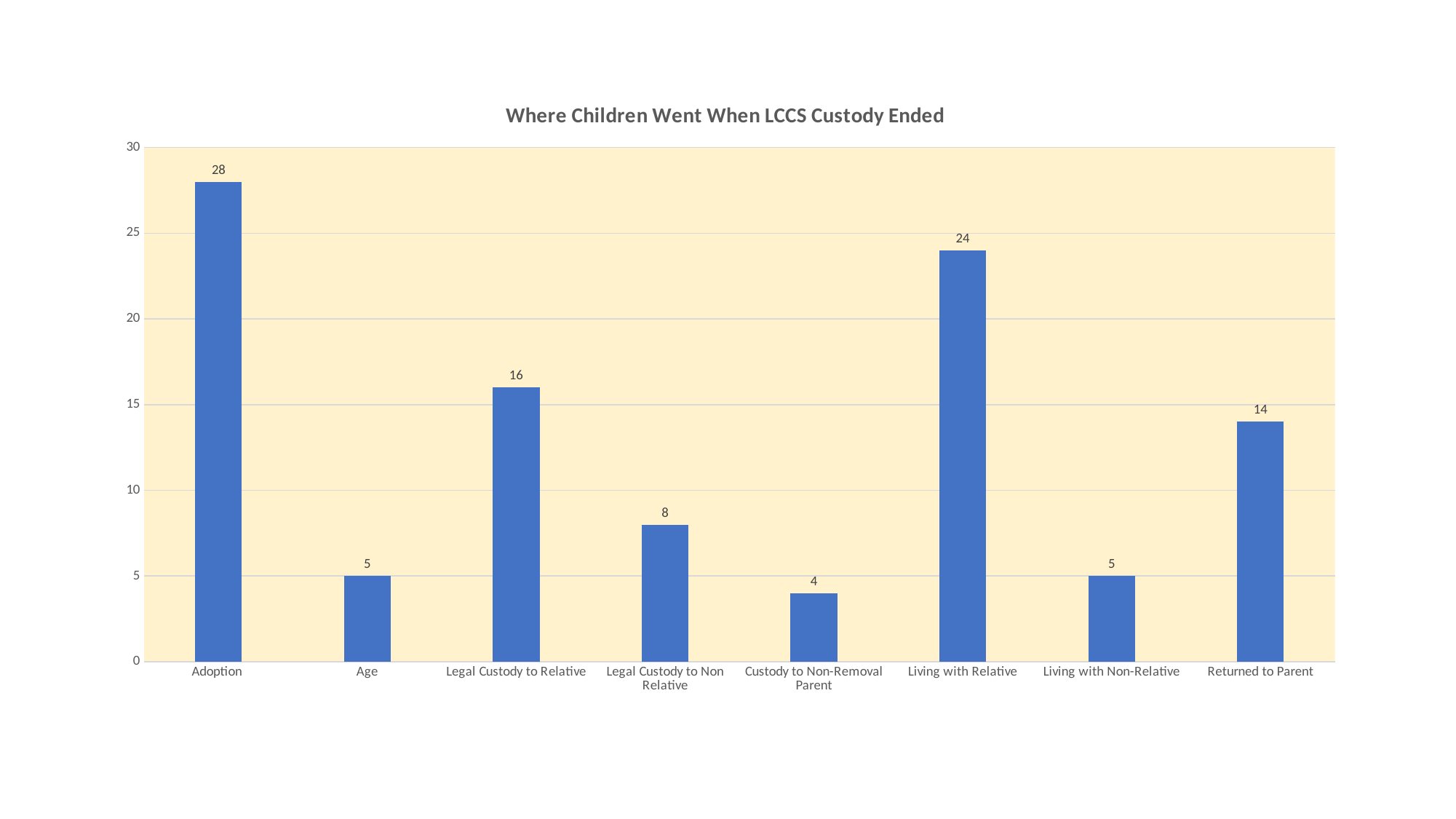
Which is larger, the value for Legal Custody to Relative or the value for Returned to Parent? Legal Custody to Relative What is the difference between the values for Adoption and Living with Relative? 4 Which category has the lowest value? Custody to Non-Removal Parent What is the value for Legal Custody to Non Relative? 8 What kind of chart is shown on the slide? bar chart What is the value for Adoption? 28 Which category has the highest value? Adoption What is the title of the chart? Where Children Went When LCCS Custody Ended What is the value for Living with Relative? 24 What is the value for Returned to Parent? 14 Is the value for Living with Relative greater or less than 20? greater How many categories are shown on the x axis? 8